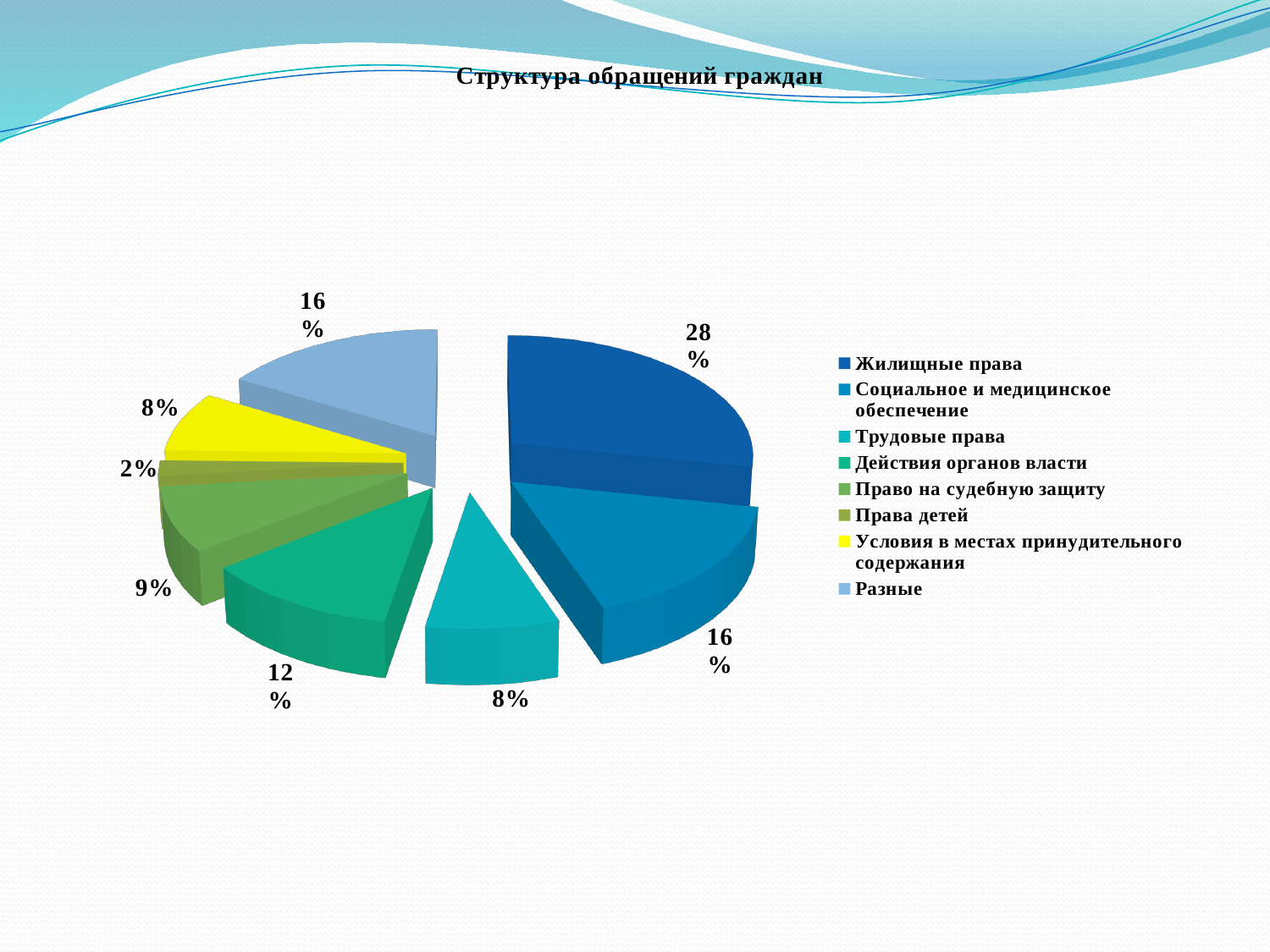
What share of the pie is Права детей? 2% Which category has the smallest share of the pie? Права детей What is the title of the chart? Структура обращений граждан What share of the pie is Право на судебную защиту? 9% What share of the pie is Жилищные права? 28% How many categories does the legend list? 8 What share of the pie is Действия органов власти? 12% What share of the pie is Разные? 16% What kind of chart is shown on the slide? Pie chart Which category has the largest share of the pie? Жилищные права Which is larger, the share of Действия органов власти or the share of Право на судебную защиту? Действия органов власти What is the difference between the shares of Жилищные права and Социальное и медицинское обеспечение? 12%